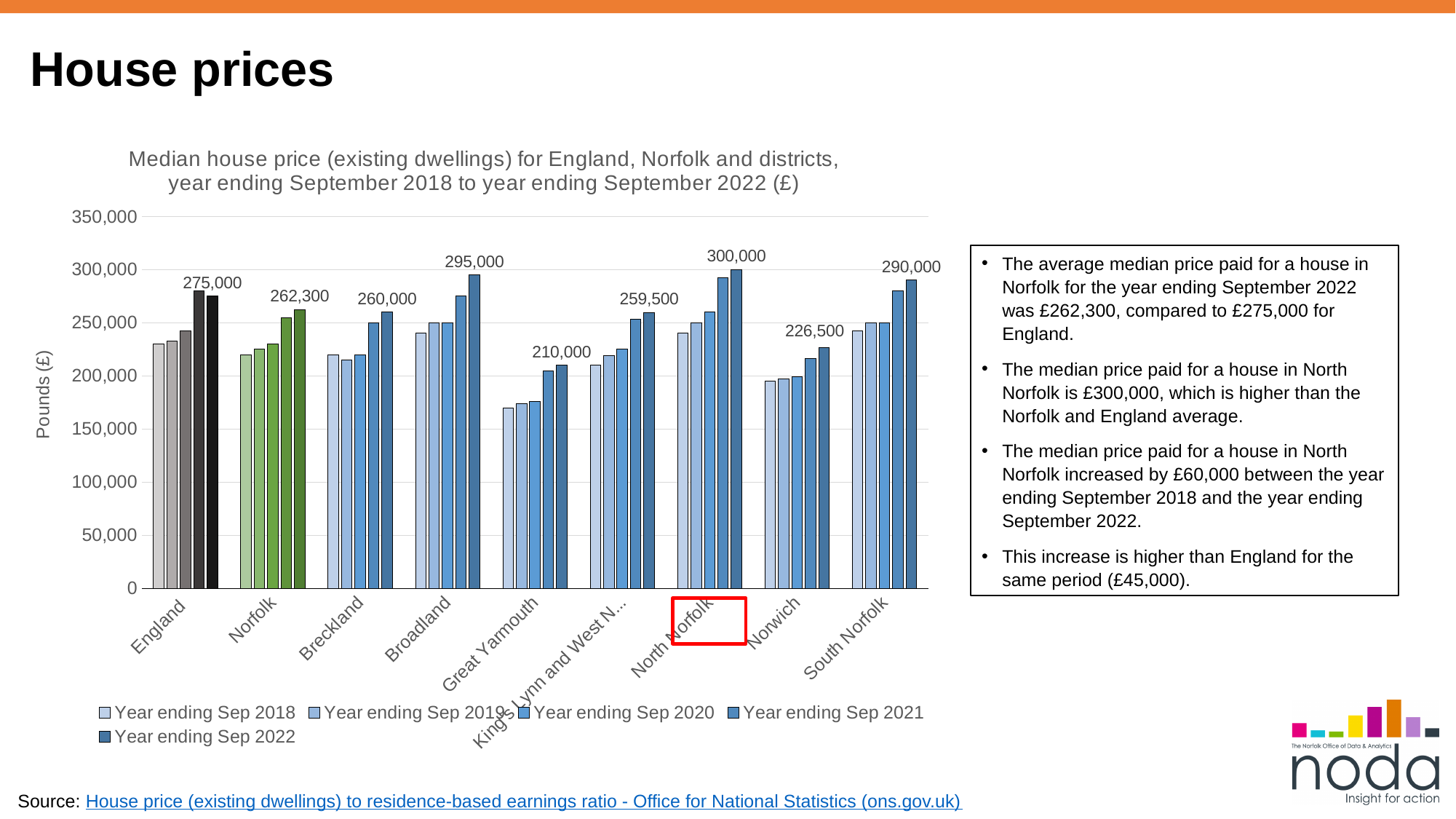
Is the value for Great Yarmouth in the year ending Sep 2018 greater or less than 200,000? less How many series does the legend list? 5 How many areas are shown on the x axis of the chart? 9 Which has the higher median house price in the year ending Sep 2022, Broadland or South Norfolk? Broadland What is the difference between the year ending Sep 2022 median house prices for North Norfolk and England? 25,000 What is the label on the y axis of the chart? Pounds (£) Do the median house prices for Norwich rise or fall from the year ending Sep 2018 to the year ending Sep 2022? rise What kind of chart is shown on the slide? bar chart What is the median house price for North Norfolk in the year ending Sep 2022? 300,000 Which area has the highest median house price in the year ending Sep 2022? North Norfolk What is the median house price for England in the year ending Sep 2022? 275,000 Which area has the lowest median house price in the year ending Sep 2022? Great Yarmouth